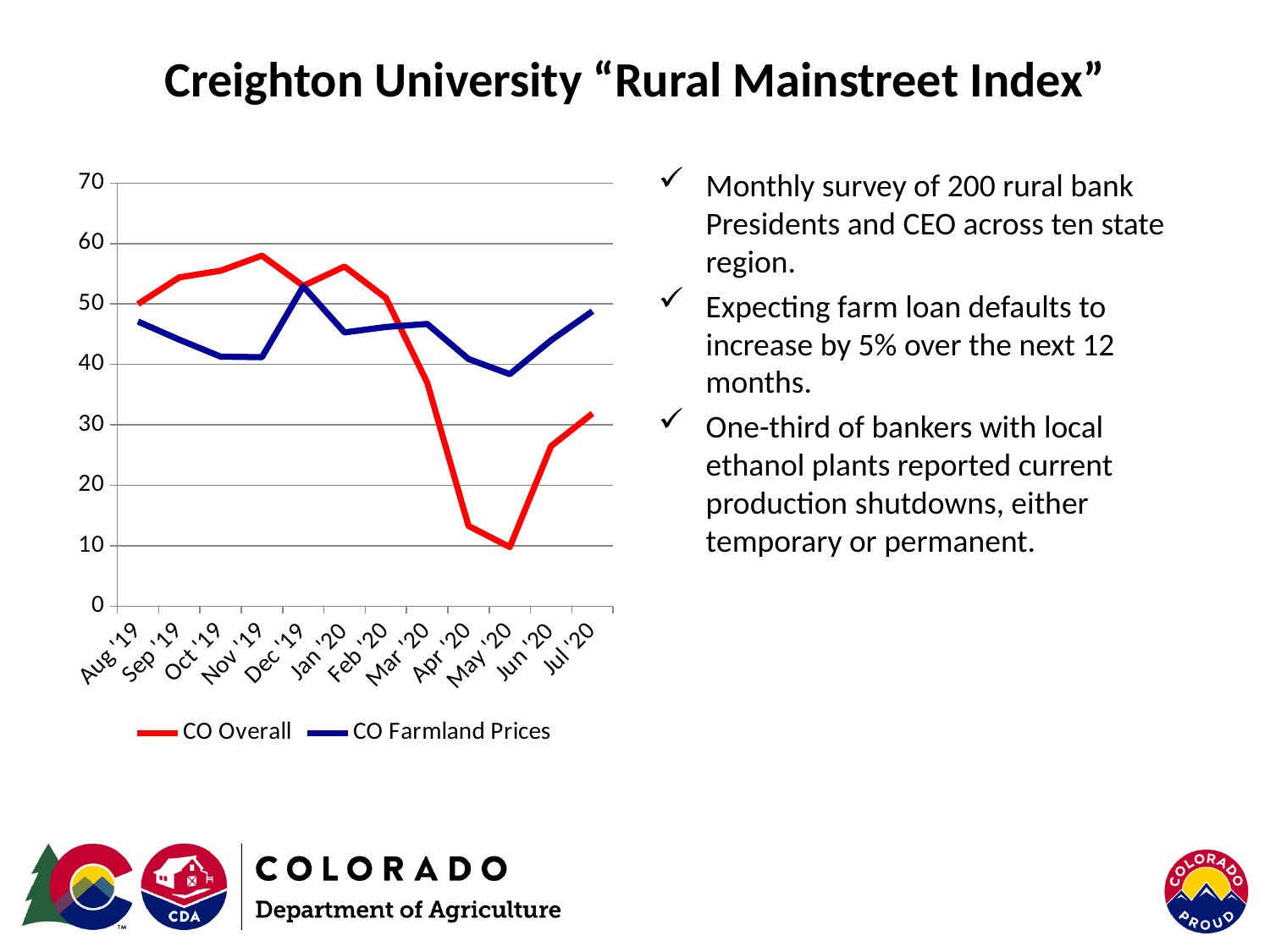
In which month does the CO Farmland Prices series reach its highest value? Dec '19 In Apr '20, which series has the larger value, CO Overall or CO Farmland Prices? CO Farmland Prices In which month does the CO Overall series reach its lowest value? May '20 Is the CO Farmland Prices value for Dec '19 greater or less than 50? greater Is the CO Overall value for May '20 greater or less than 20? less Does the CO Overall series rise or fall from Jan '20 to May '20? fall What kind of chart is shown on the slide? line chart What colour is the line for the CO Overall series? red How many series does the chart legend list? 2 How many months are plotted along the x axis of the chart? 12 In Nov '19, which series has the larger value, CO Overall or CO Farmland Prices? CO Overall Is the CO Overall value for Nov '19 greater or less than 50? greater